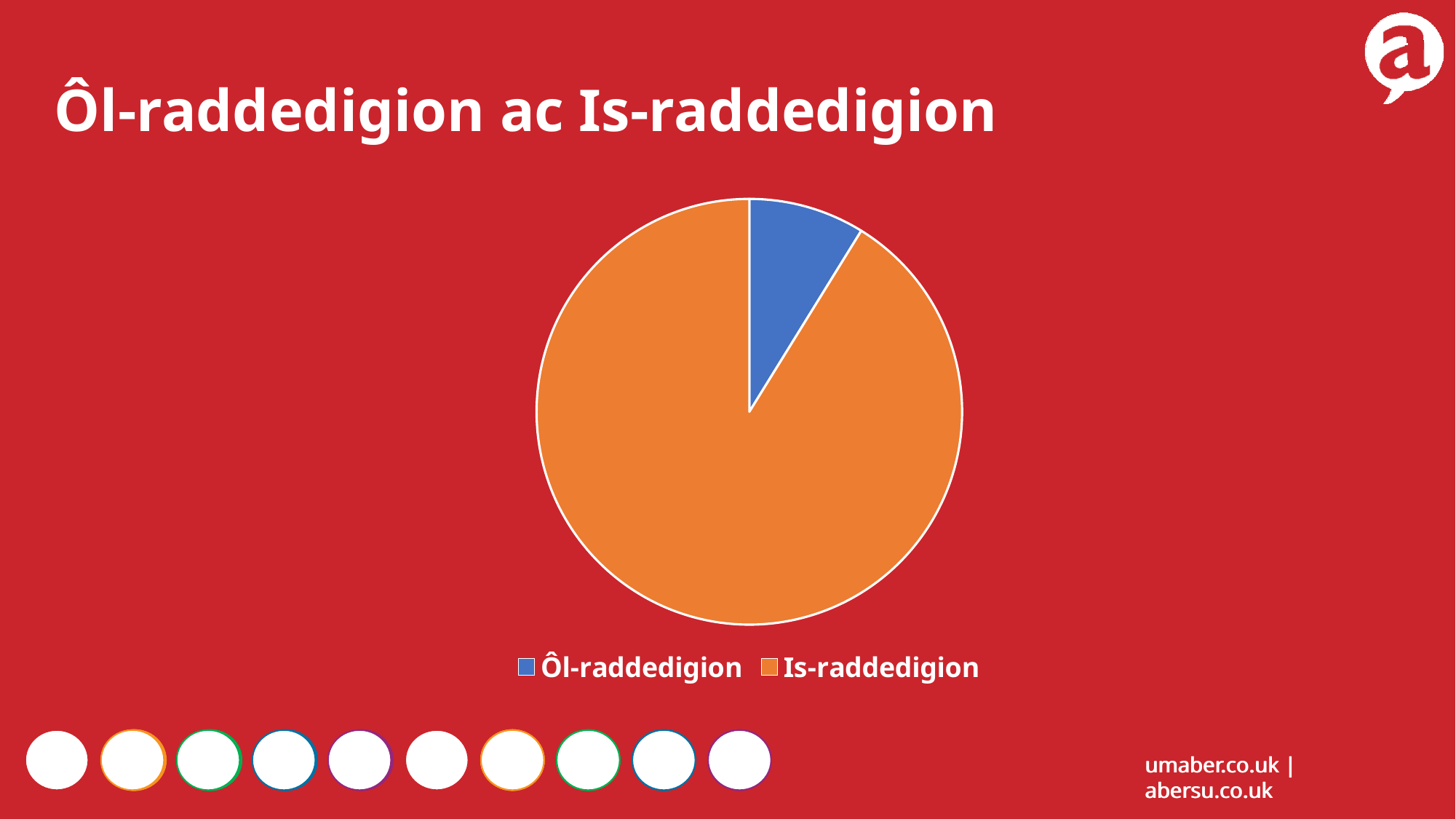
Does Is-raddedigion account for more or less than half of the pie chart? more How many slices does the pie chart have? 2 What is the title of the slide containing the pie chart? Ôl-raddedigion ac Is-raddedigion Which category has the smallest slice of the pie chart? Ôl-raddedigion What colour is the Ôl-raddedigion slice in the pie chart? blue Which slice is larger, Ôl-raddedigion or Is-raddedigion? Is-raddedigion Which category has the largest slice of the pie chart? Is-raddedigion What kind of chart is shown on the slide? pie chart How many entries does the legend of the pie chart list? 2